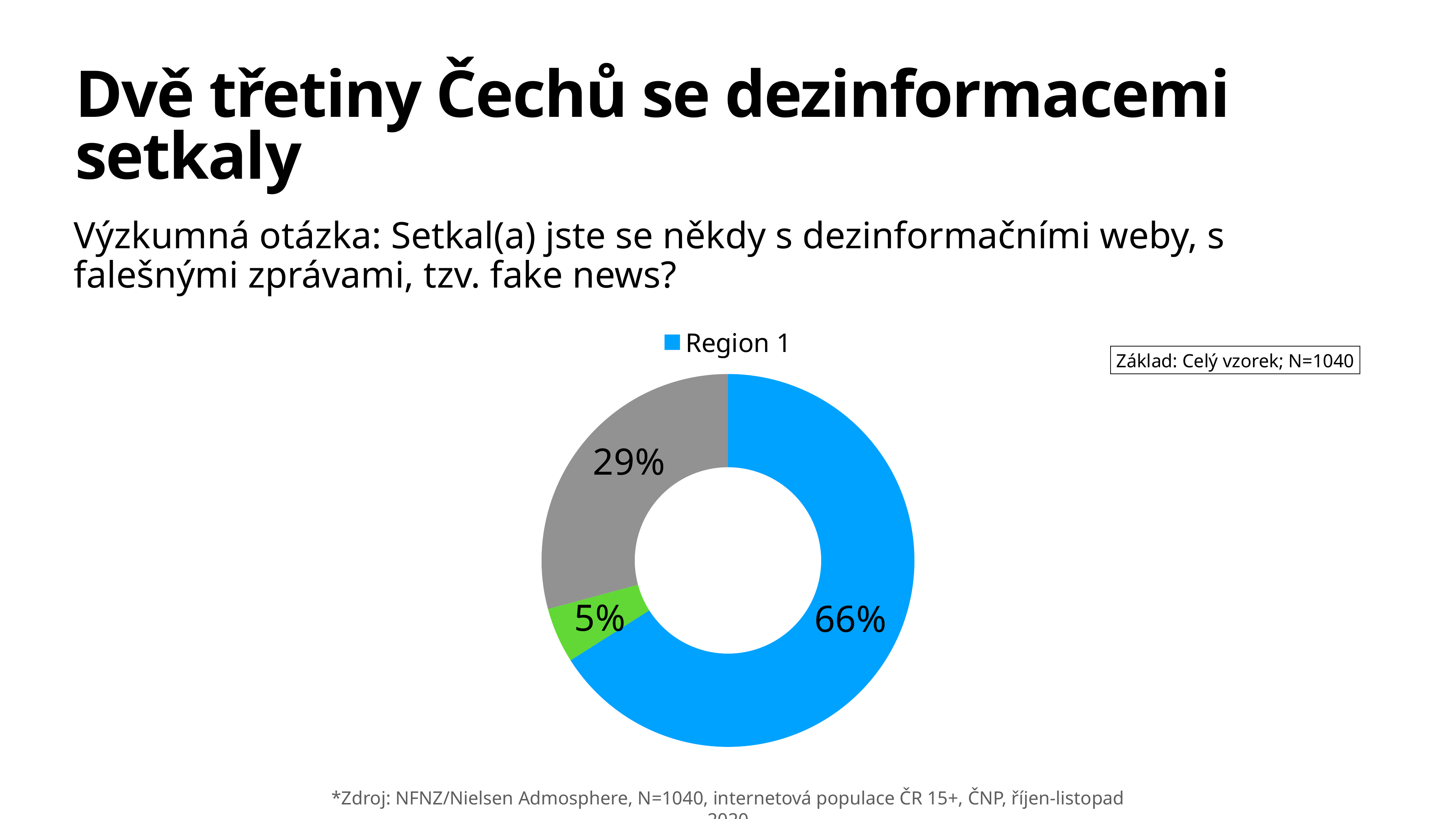
What is the difference between the blue slice and the grey slice? 37% Which colour slice is the largest in the doughnut chart? blue What is the difference between the grey slice and the green slice? 24% Which is larger, the grey slice or the green slice? grey slice What is the value of the blue slice of the doughnut chart? 66% What is the legend entry shown above the doughnut chart? Region 1 How many entries does the chart legend list? 1 Which colour slice is the smallest in the doughnut chart? green What is the value of the green slice of the doughnut chart? 5% What kind of chart is shown on the slide? doughnut chart How many slices does the doughnut chart have? 3 What is the value of the grey slice of the doughnut chart? 29%